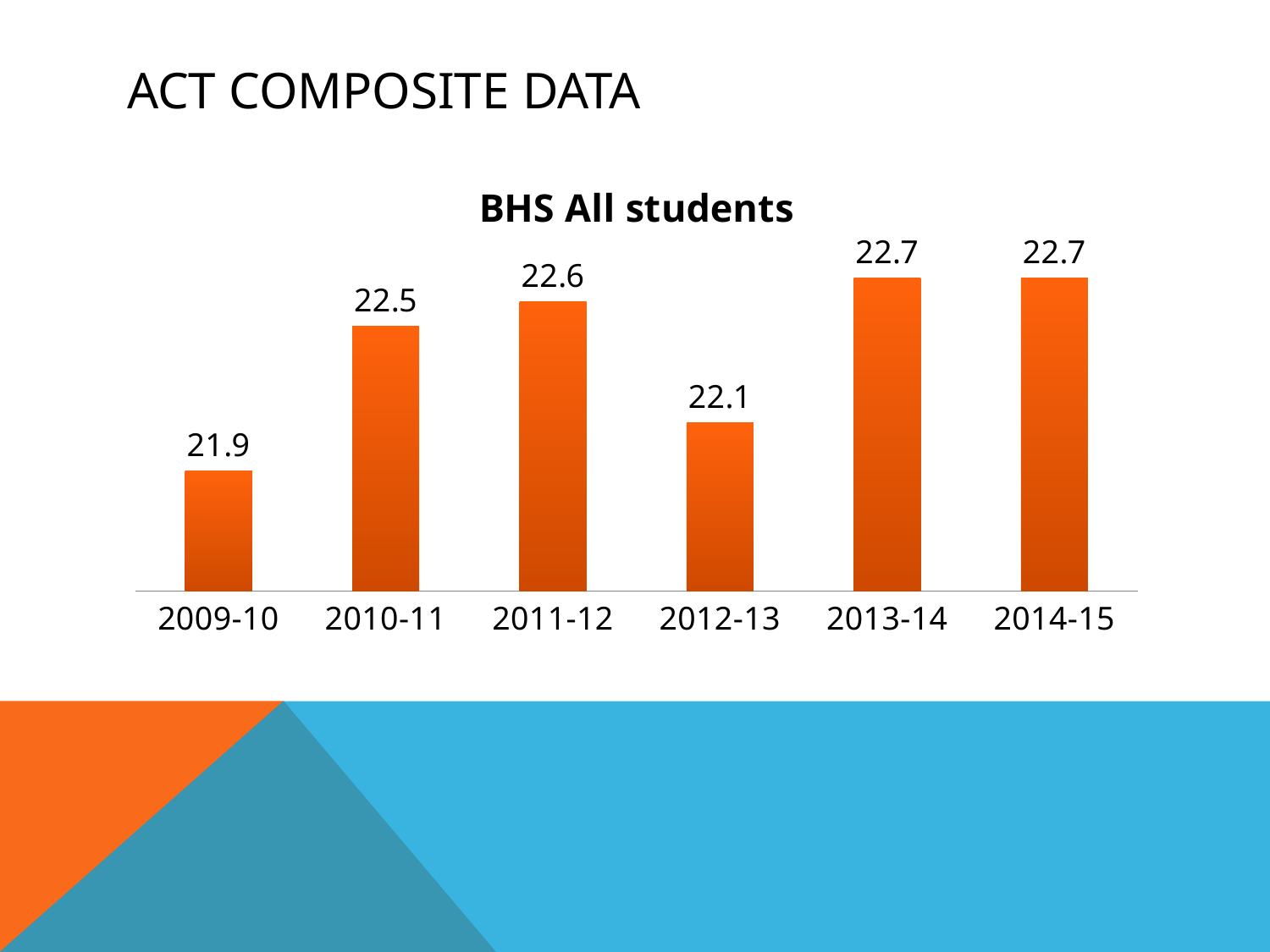
What is the title of the chart? BHS All students How many years are shown on the x axis? 6 What is the value for 2011-12? 22.6 What is the value for 2012-13? 22.1 What kind of chart is shown? Bar chart Which year has the lowest value? 2009-10 Do the values for 2013-14 and 2014-15 differ? No, both are 22.7 What colour are the bars? Orange What is the difference between the values for 2011-12 and 2012-13? 0.5 What is the difference between the values for 2013-14 and 2009-10? 0.8 Which is larger, the value for 2010-11 or the value for 2012-13? 2010-11 What is the value for 2009-10? 21.9